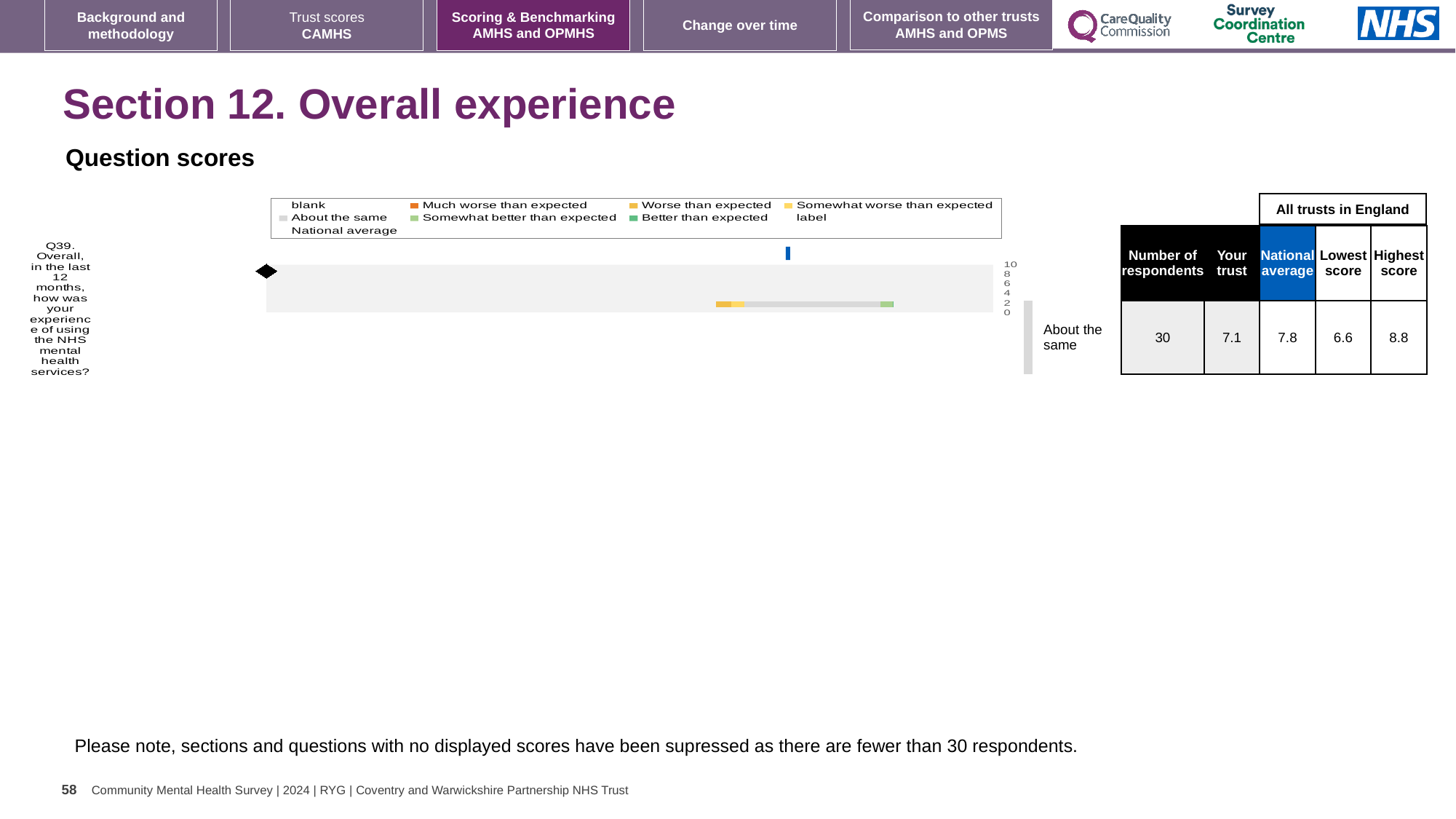
What is the 'Your trust' score for Q39? 7.1 What is the highest tick value shown on the chart's score axis? 10 Which is higher for Q39, the trust's score or the national average? National average How many questions are plotted in the question scores chart? 1 Which benchmark category is Q39 (overall experience) placed in? About the same How many respondents answered Q39? 30 What is the highest score among all trusts in England for Q39? 8.8 What is the lowest score among all trusts in England for Q39? 6.6 By how much does the national average exceed the trust's score for Q39? 0.7 What is the national average score for Q39? 7.8 What is the difference between the highest and lowest trust scores for Q39? 2.2 What kind of chart is used to show the Q39 question score? bar chart